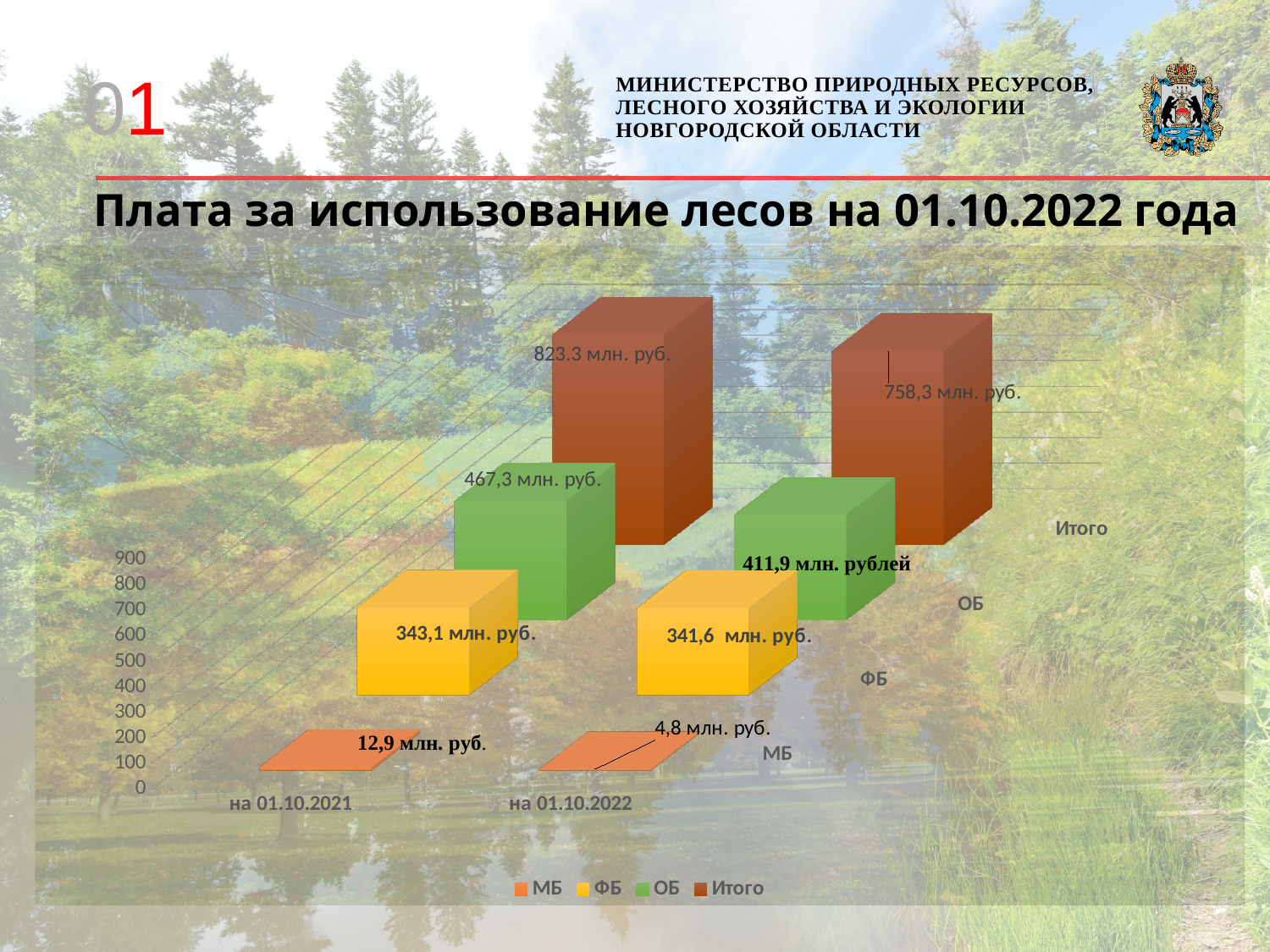
What is the value for ОБ on 01.10.2021? 467,3 млн. руб. Which series has the lowest value on 01.10.2021? МБ What is the value for ФБ on 01.10.2021? 343,1 млн. руб. Which is larger: ОБ on 01.10.2021 or ОБ on 01.10.2022? ОБ on 01.10.2021 What is the difference between the ОБ values on 01.10.2021 and 01.10.2022? 55,4 млн. руб. What is the title of the chart on the slide? Плата за использование лесов на 01.10.2022 года What is the value for МБ on 01.10.2022? 4,8 млн. руб. What kind of chart is shown on the slide? Bar chart How many series does the legend list? 4 What is the value for Итого on 01.10.2022? 758,3 млн. руб. What is the difference between the МБ values on 01.10.2021 and 01.10.2022? 8,1 млн. руб. Which series has the highest value on 01.10.2022? Итого